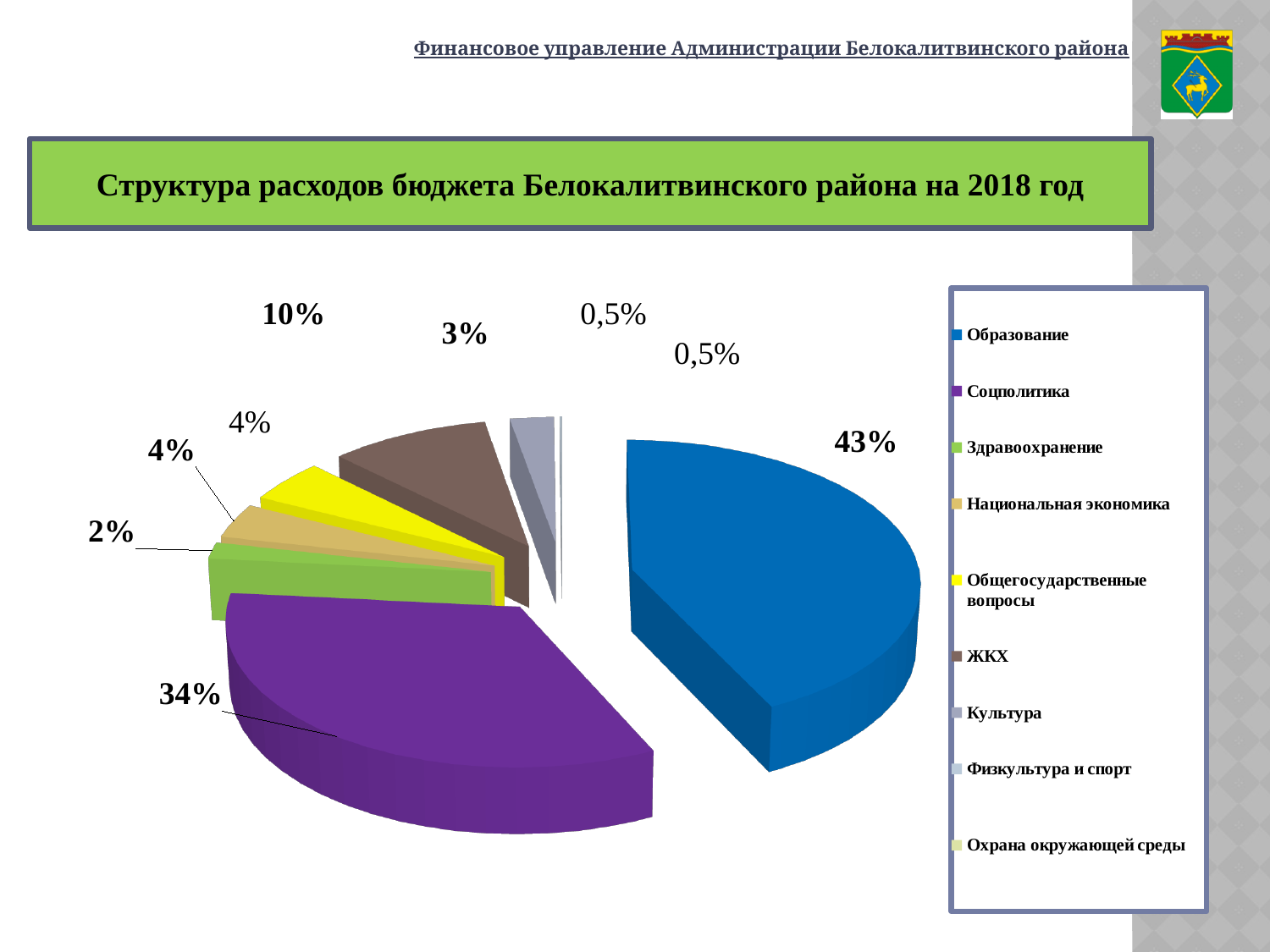
What share of the pie does ЖКХ have? 10% What share of the pie does Соцполитика have? 34% What share of the pie does Здравоохранение have? 2% What colour is the slice for Соцполитика? purple Which is larger, the share for ЖКХ or the share for Культура? ЖКХ What kind of chart is shown on the slide? pie chart What is the difference in percentage points between Образование and Соцполитика? 9 What is the title of the slide above the chart? Структура расходов бюджета Белокалитвинского района на 2018 год How many categories does the legend list? 9 What share of the pie does Культура have? 3% Which category has the largest share of the pie? Образование What share of the pie does Образование have? 43%